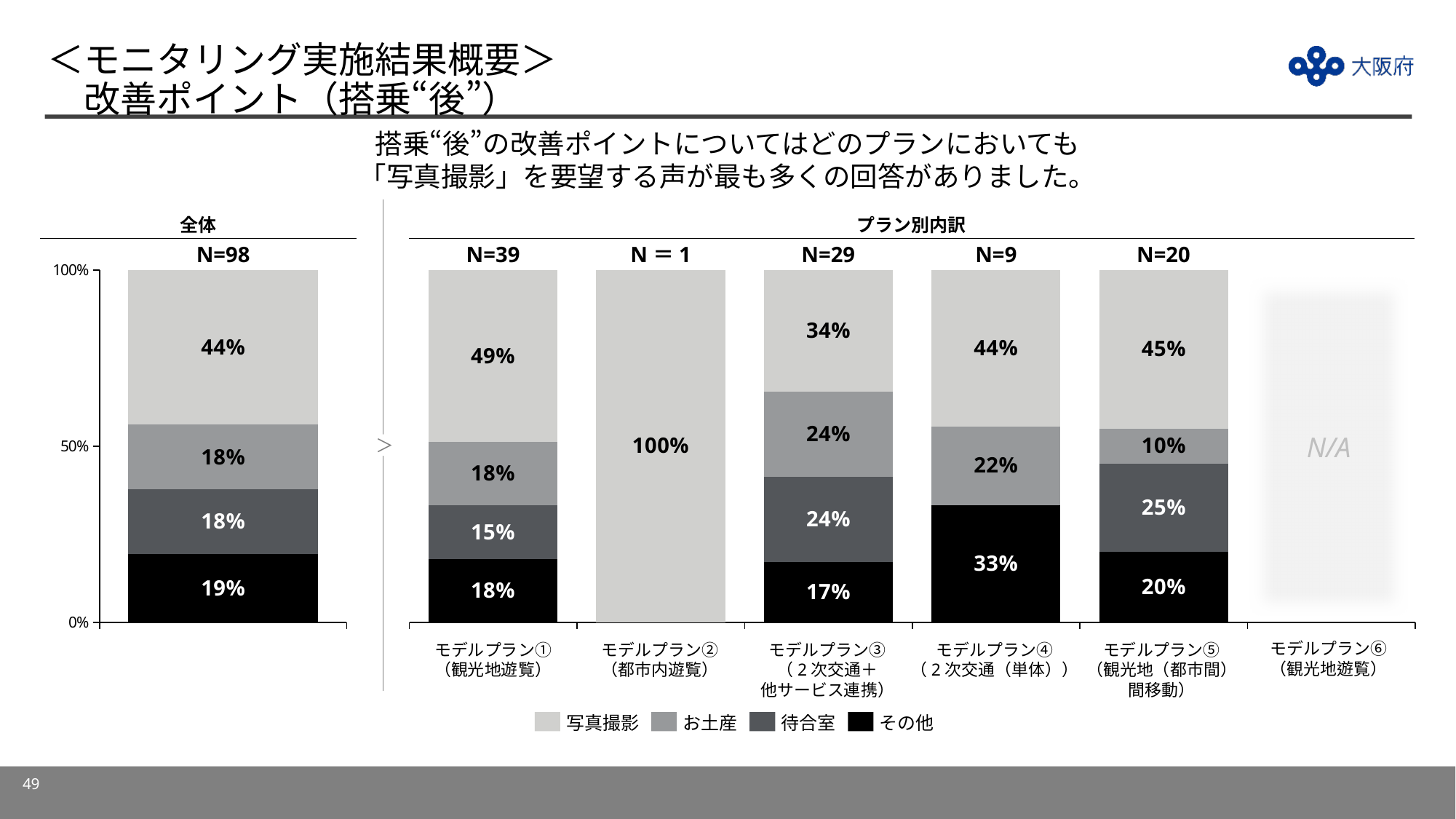
In the プラン別内訳 chart, which model plan has the highest 写真撮影 share? モデルプラン② In the プラン別内訳 chart, what is the その他 value for モデルプラン④? 33% How many series does the legend list? 4 In the プラン別内訳 chart, which is larger: the 写真撮影 value for モデルプラン① or for モデルプラン⑤? モデルプラン① In the プラン別内訳 chart, what is the お土産 value for モデルプラン⑤? 10% In the プラン別内訳 chart, what is the difference between the その他 value for モデルプラン④ and for モデルプラン③? 16 percentage points In the 全体 chart, what is the value for 写真撮影? 44% What kind of chart is the 全体 chart? Stacked bar chart In the プラン別内訳 chart, what is the N shown above モデルプラン③? N=29 In the プラン別内訳 chart, what is the 写真撮影 value for モデルプラン③? 34% In the 全体 chart, what is the value for その他? 19% In the プラン別内訳 chart, which model plan with data has the lowest その他 share? モデルプラン②